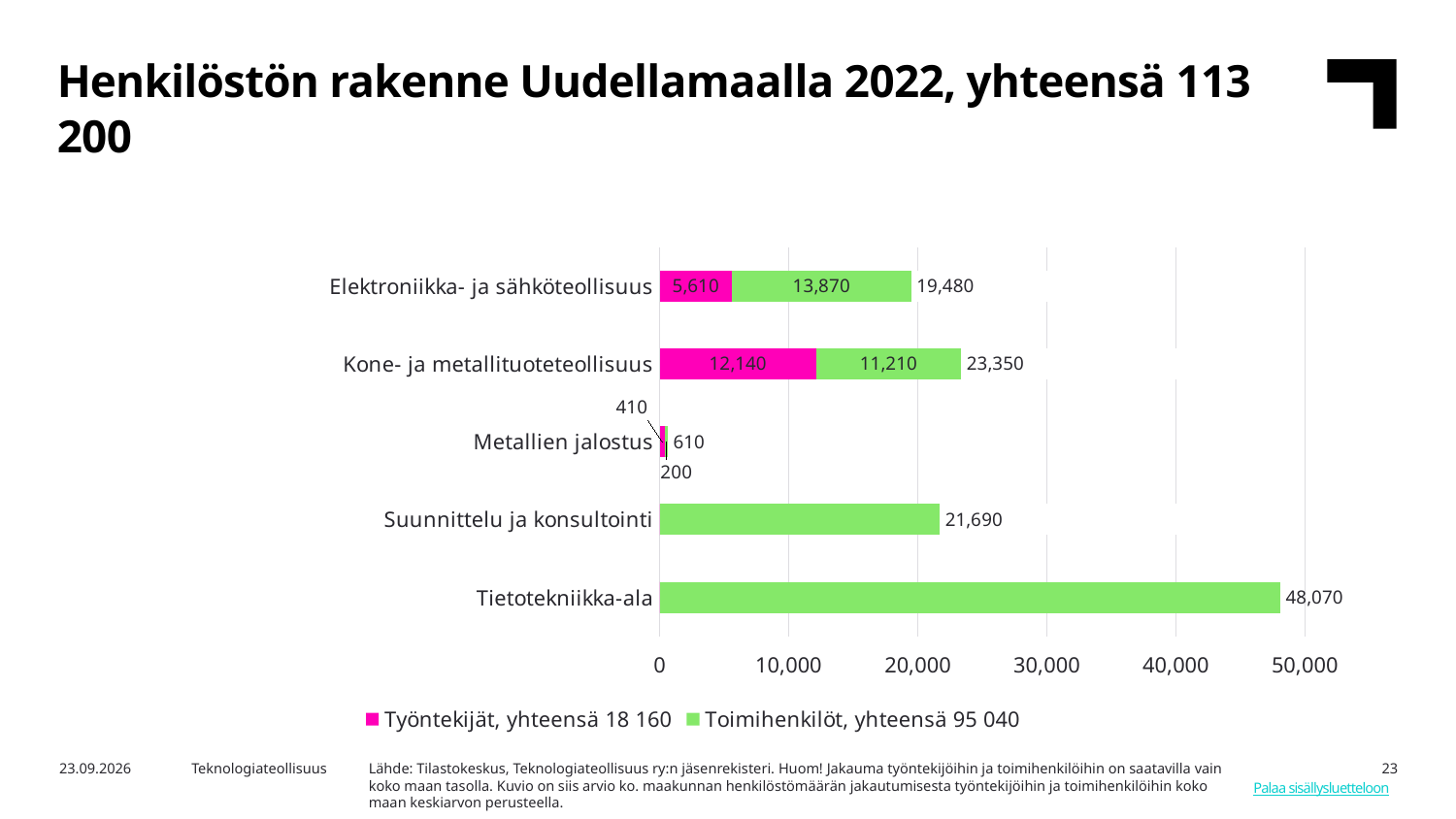
What is the Toimihenkilöt value for Elektroniikka- ja sähköteollisuus? 13,870 What is the total shown for the Tietotekniikka-ala bar? 48,070 Which category has the lowest total? Metallien jalostus How many categories are shown on the chart? 5 Which category has the highest total? Tietotekniikka-ala What is the Työntekijät value for Kone- ja metallituoteteollisuus? 12,140 What kind of chart is shown? stacked bar chart What is the difference between the Työntekijät and Toimihenkilöt values for Kone- ja metallituoteteollisuus? 930 Which is larger: the total for Suunnittelu ja konsultointi or the total for Kone- ja metallituoteteollisuus? Kone- ja metallituoteteollisuus Is the total for Elektroniikka- ja sähköteollisuus greater or less than 20,000? less How many series does the legend list? 2 What is the total of the stacked bar for Metallien jalostus? 610